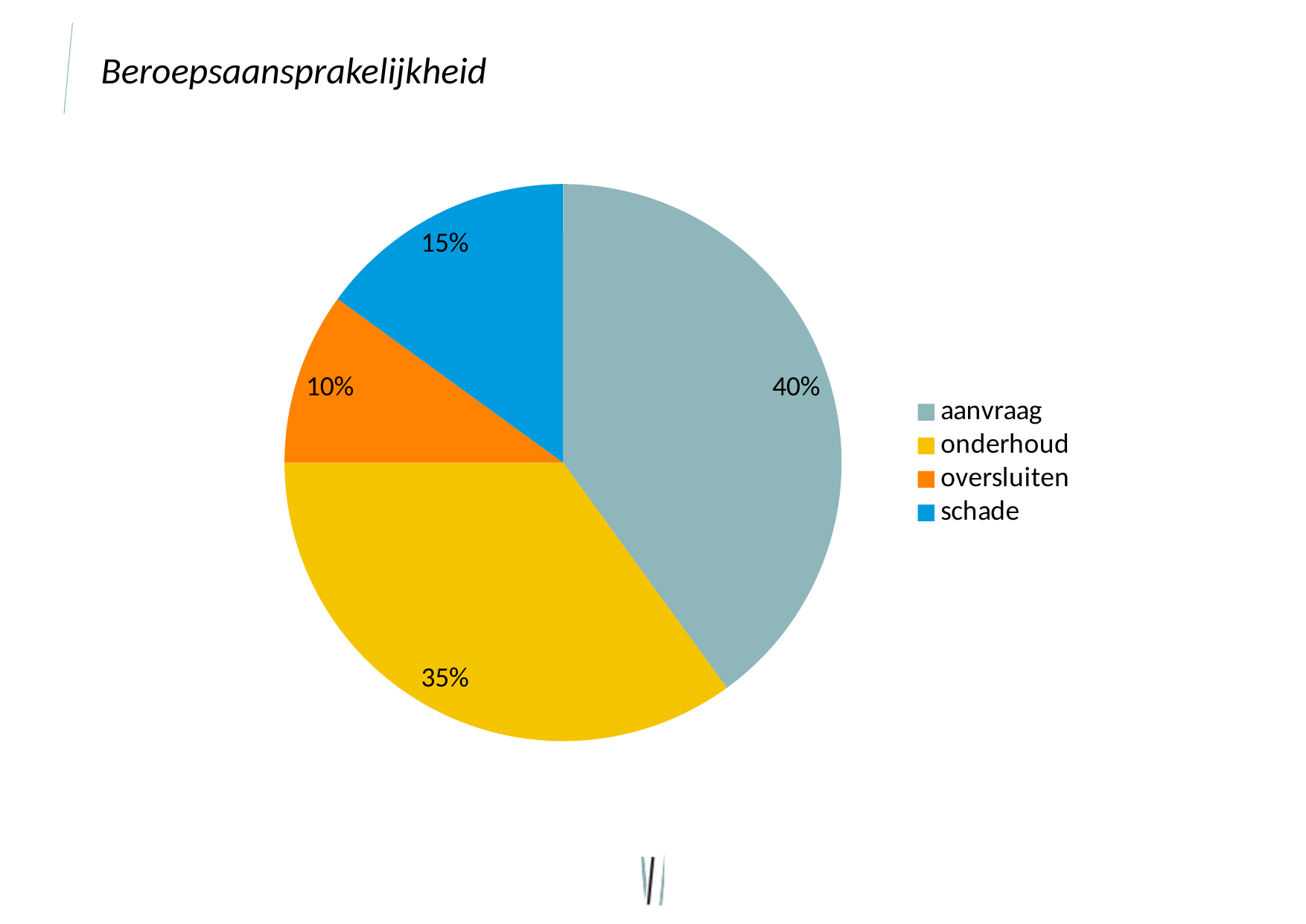
Which category has the largest slice of the pie? aanvraag What kind of chart is shown on the slide? pie chart What is the difference in percentage points between schade and oversluiten? 5% Which is larger, the slice for schade or the slice for oversluiten? schade What is the difference in percentage points between aanvraag and onderhoud? 5% What share of the pie does oversluiten have? 10% What share of the pie does schade have? 15% Which category has the smallest slice of the pie? oversluiten What is the title of the slide containing the pie chart? Beroepsaansprakelijkheid What share of the pie does onderhoud have? 35% How many categories does the pie chart have? 4